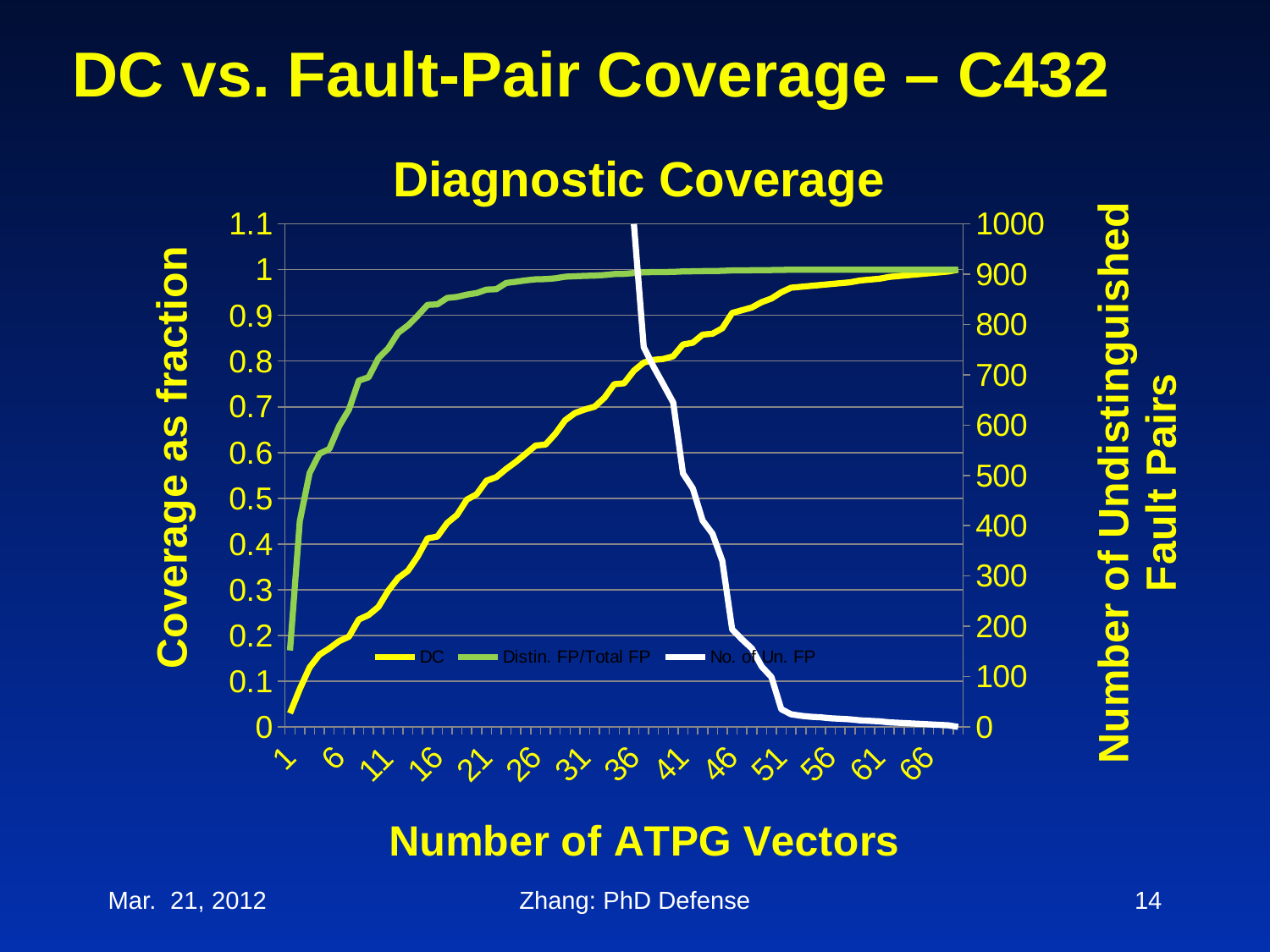
Is the No. of Un. FP value at 56 ATPG vectors greater or less than 100? less What is the title of the chart? Diagnostic Coverage How many series does the legend list? 3 Does the No. of Un. FP series rise or fall as the number of ATPG vectors increases? fall What kind of chart is shown on the slide? line chart Is the DC value at 1 ATPG vector greater or less than 0.1? less Does the DC series rise or fall as the number of ATPG vectors increases? rise Is the Distin. FP/Total FP value at 16 ATPG vectors greater or less than 0.9? greater Does the Distin. FP/Total FP series rise or fall as the number of ATPG vectors increases? rise What is the label of the x axis? Number of ATPG Vectors At 11 ATPG vectors, which series has the larger value, DC or Distin. FP/Total FP? Distin. FP/Total FP